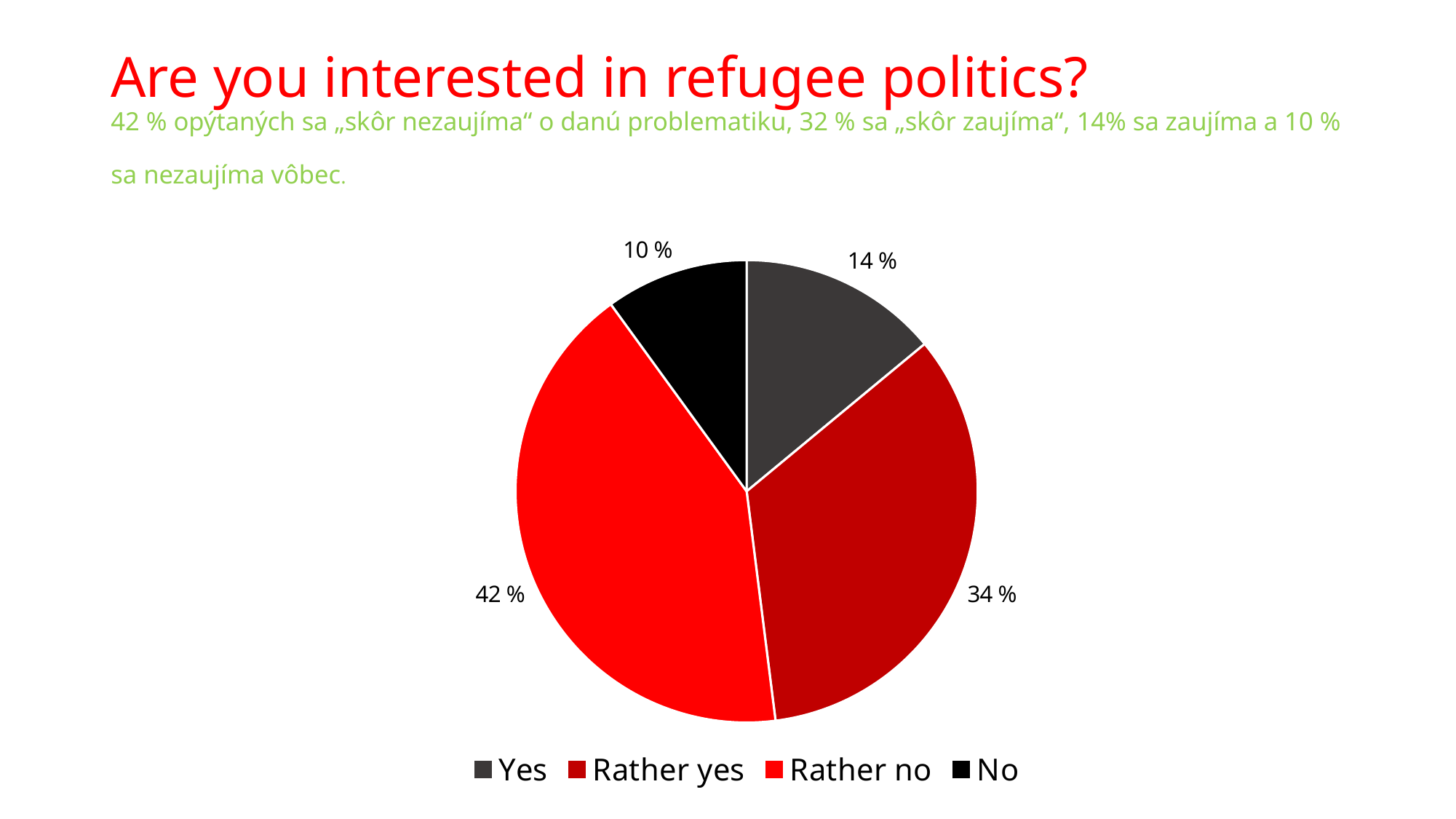
What percentage of respondents answered "Rather yes"? 34 % What percentage of respondents answered "Rather no"? 42 % What is the difference in percentage points between "Rather no" and "Rather yes"? 8 How many categories does the pie chart have? 4 Which colour represents the "No" category in the legend? black What percentage of respondents answered "Yes"? 14 % Which answer category has the smallest share of the pie? No What percentage of respondents answered "No"? 10 % What kind of chart is shown on the slide? pie chart Which answer category has the largest share of the pie? Rather no What is the title of the slide above the chart? Are you interested in refugee politics? Which is larger, the share for "Yes" or the share for "No"? Yes